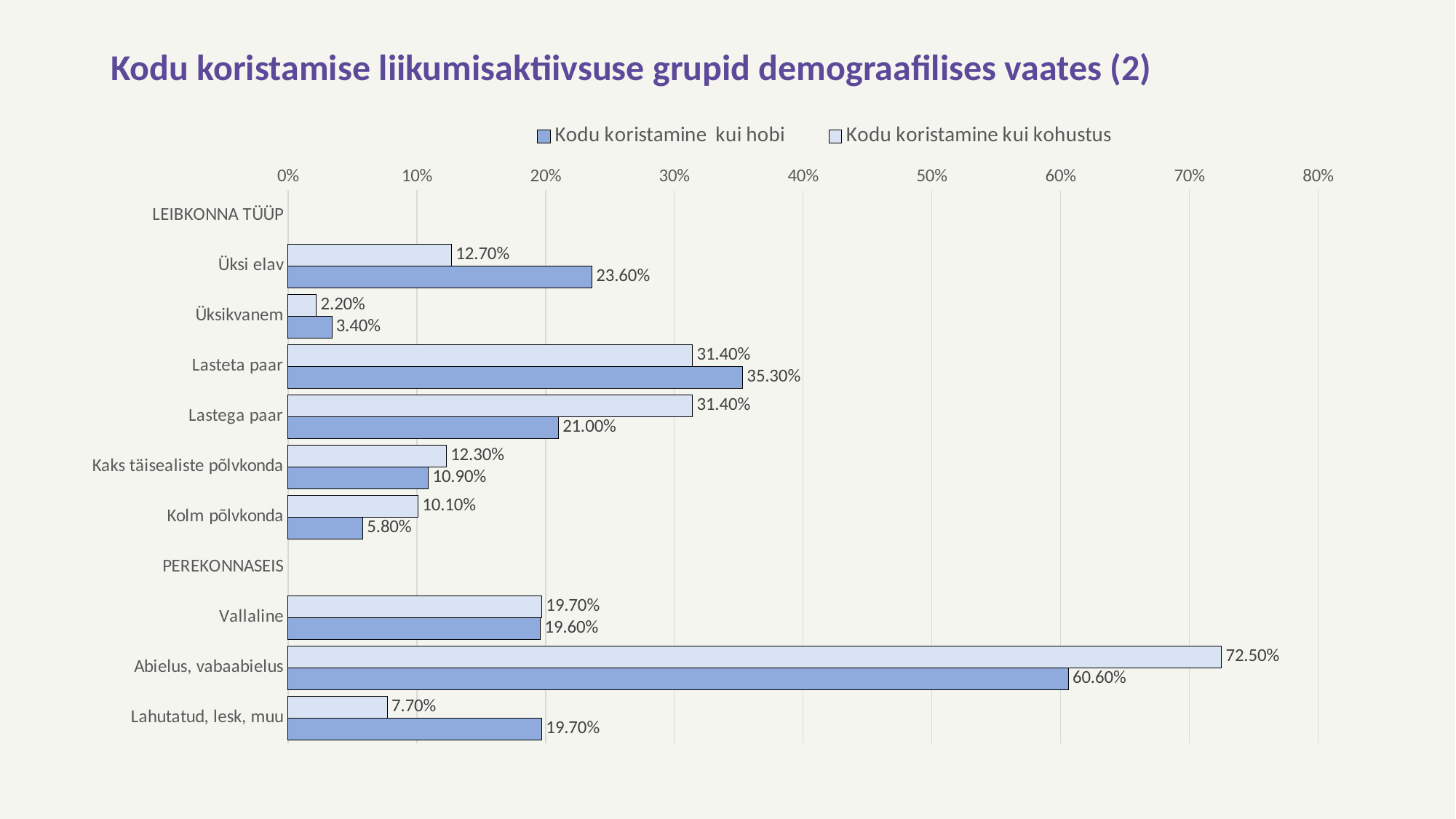
What is the value for Üksi elav in the Kodu koristamine kui hobi series? 23.60% What is the title of the chart? Kodu koristamise liikumisaktiivsuse grupid demograafilises vaates (2) What is the value for Abielus, vabaabielus in the Kodu koristamine kui kohustus series? 72.50% How many categories are listed under the PEREKONNASEIS group? 3 Is the Kodu koristamine kui hobi value for Lasteta paar greater or less than 30%? greater What kind of chart is shown on the slide? Bar chart How many series does the legend list? 2 Which category has the highest value in the Kodu koristamine kui hobi series? Abielus, vabaabielus For Lahutatud, lesk, muu, which series has the larger value? Kodu koristamine kui hobi Which category has the lowest value in the Kodu koristamine kui kohustus series? Üksikvanem What is the value for Kolm põlvkonda in the Kodu koristamine kui kohustus series? 10.10% What is the difference between the Kodu koristamine kui kohustus and Kodu koristamine kui hobi values for Abielus, vabaabielus? 11.90%